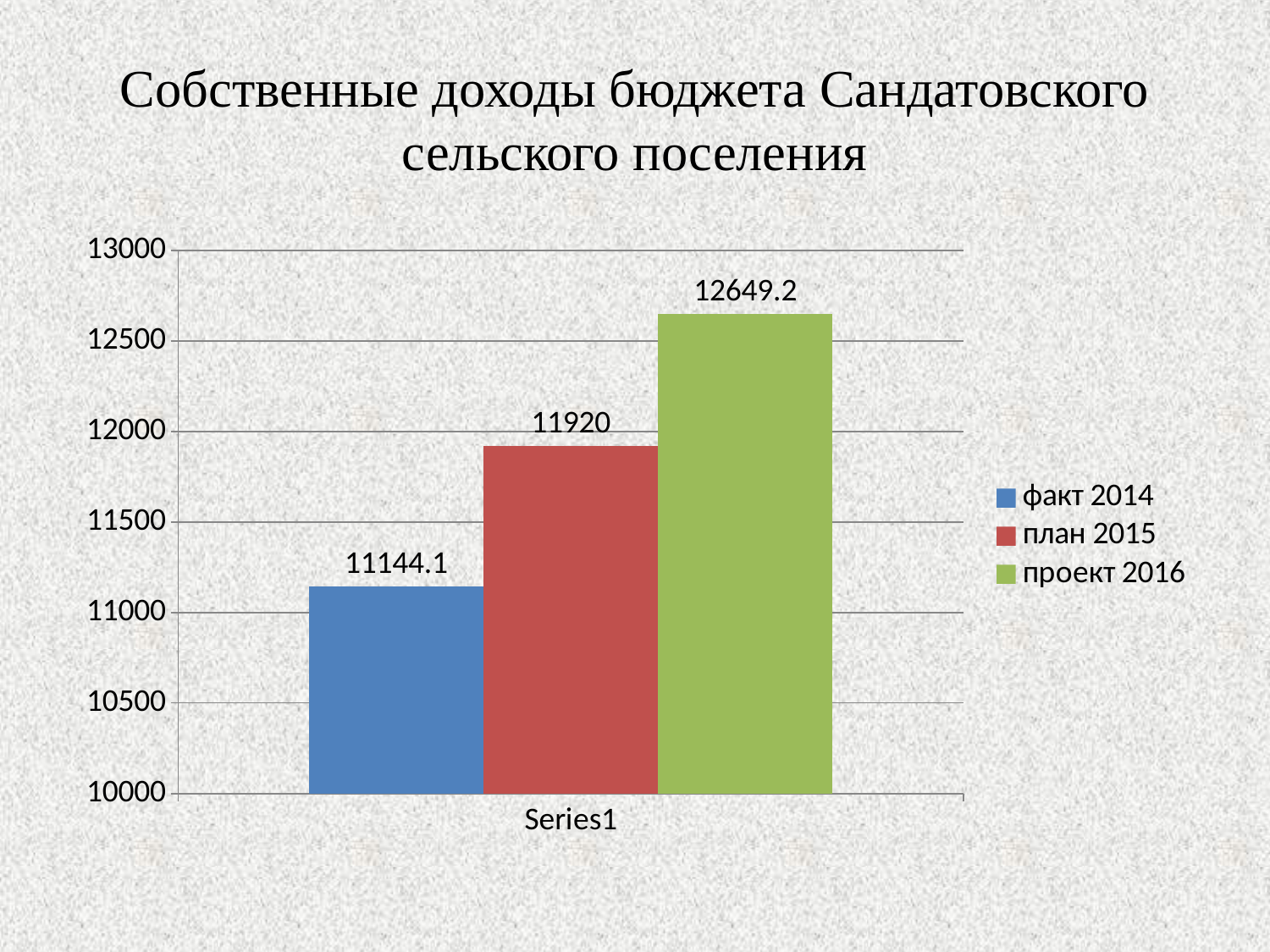
Which series has the lowest value? факт 2014 What kind of chart is shown on the slide? bar chart Is the value for факт 2014 greater or less than 11500? less What colour is the bar for план 2015? red What is the difference between the values for план 2015 and факт 2014? 775.9 What is the value for план 2015? 11920 What is the difference between the values for проект 2016 and план 2015? 729.2 How many series does the legend list? 3 Which series has the highest value? проект 2016 What is the value for факт 2014? 11144.1 What is the value for проект 2016? 12649.2 Which is larger, the value for план 2015 or the value for проект 2016? проект 2016